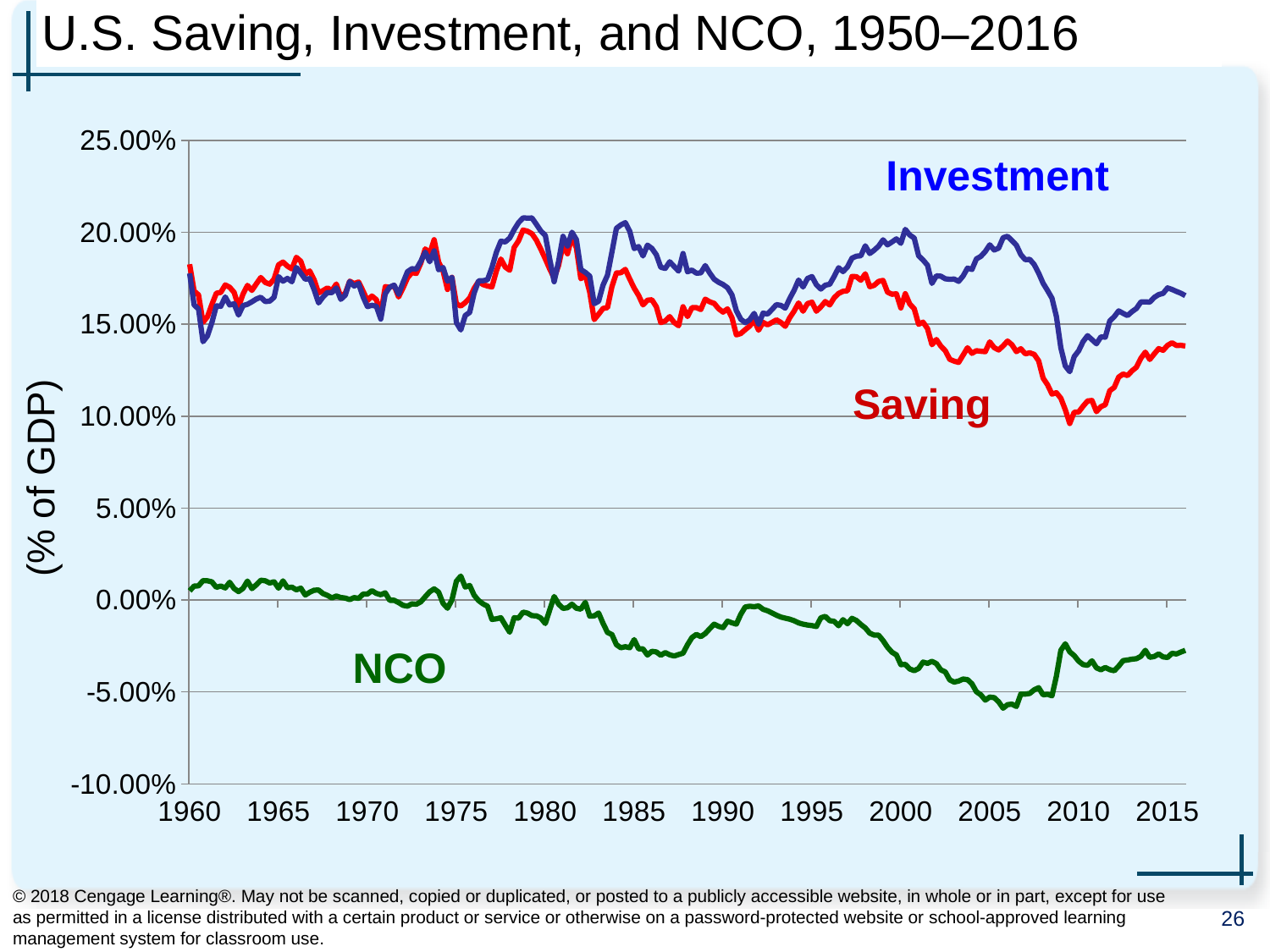
In 2015, which is higher, Investment or Saving? Investment What is the label on the vertical axis? (% of GDP) Does the NCO line rise or fall between 2000 and 2006? fall Is the value for Investment in 2000 greater or less than 15.00%? greater Is the value for Saving in 2015 greater or less than 15.00%? less Is the value for NCO in 1990 greater or less than 0.00%? less What is the title of the chart? U.S. Saving, Investment, and NCO, 1950–2016 How many series are plotted on the chart? 3 What kind of chart is shown on the slide? line chart Does the Saving line rise or fall between 2010 and 2015? rise Which series has the lowest values across the whole period? NCO